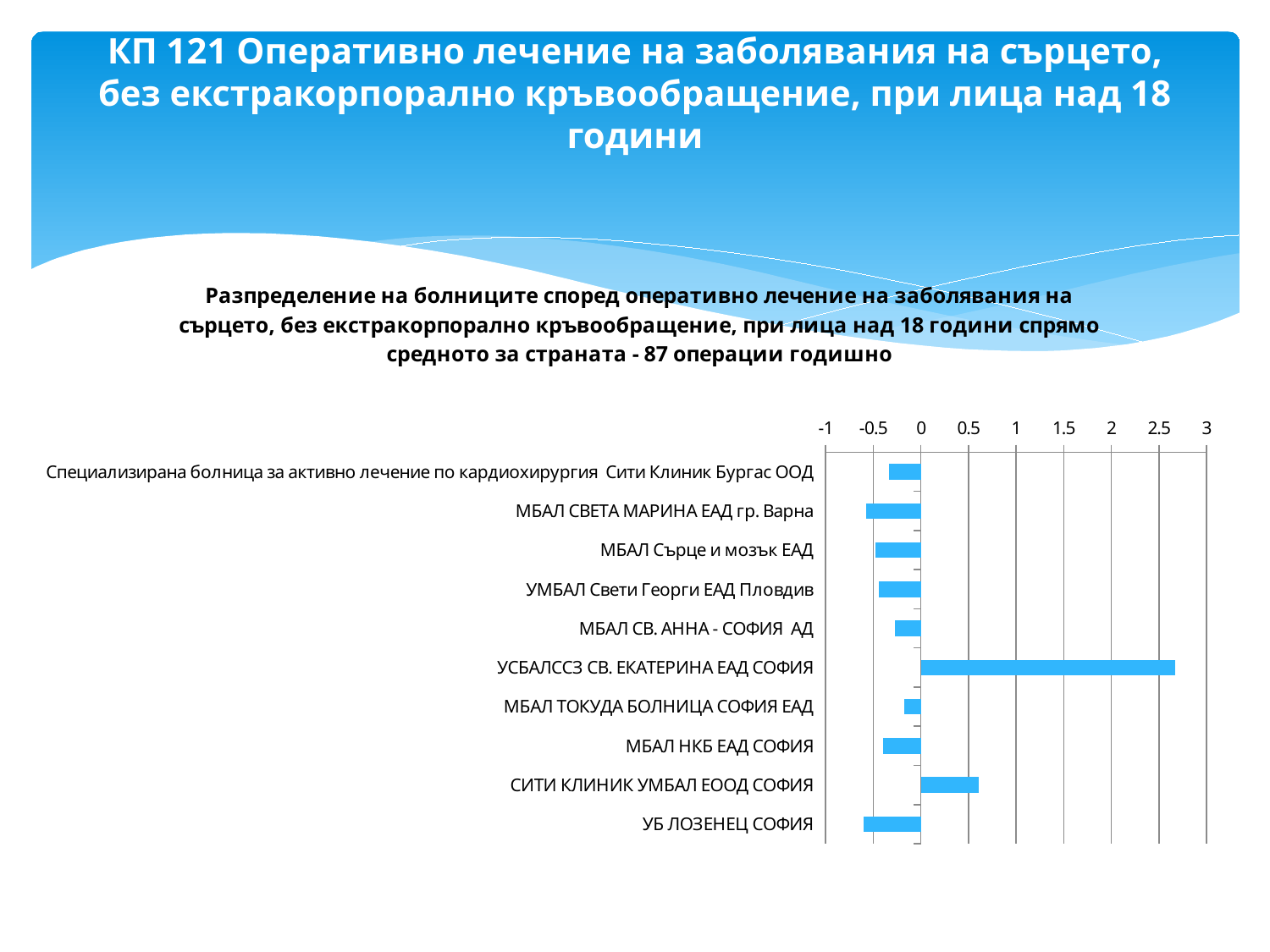
Which has the larger value: МБАЛ ТОКУДА БОЛНИЦА СОФИЯ ЕАД or УБ ЛОЗЕНЕЦ СОФИЯ? МБАЛ ТОКУДА БОЛНИЦА СОФИЯ ЕАД Is the value for МБАЛ ТОКУДА БОЛНИЦА СОФИЯ ЕАД greater or less than -0.5? greater Which has the larger value: УСБАЛССЗ СВ. ЕКАТЕРИНА ЕАД СОФИЯ or СИТИ КЛИНИК УМБАЛ ЕООД СОФИЯ? УСБАЛССЗ СВ. ЕКАТЕРИНА ЕАД СОФИЯ Is the value for УБ ЛОЗЕНЕЦ СОФИЯ greater or less than 0? less Is the value for СИТИ КЛИНИК УМБАЛ ЕООД СОФИЯ greater or less than 0.5? greater How many hospitals have a positive value (bar extending to the right of 0)? 2 What is the highest value shown on the horizontal axis of the chart? 3 How many hospitals are listed as categories in the chart? 10 What kind of chart is shown on the slide? bar chart According to the chart subtitle, what is the national average number of operations per year? 87 Which hospital has the highest value in the chart? УСБАЛССЗ СВ. ЕКАТЕРИНА ЕАД СОФИЯ